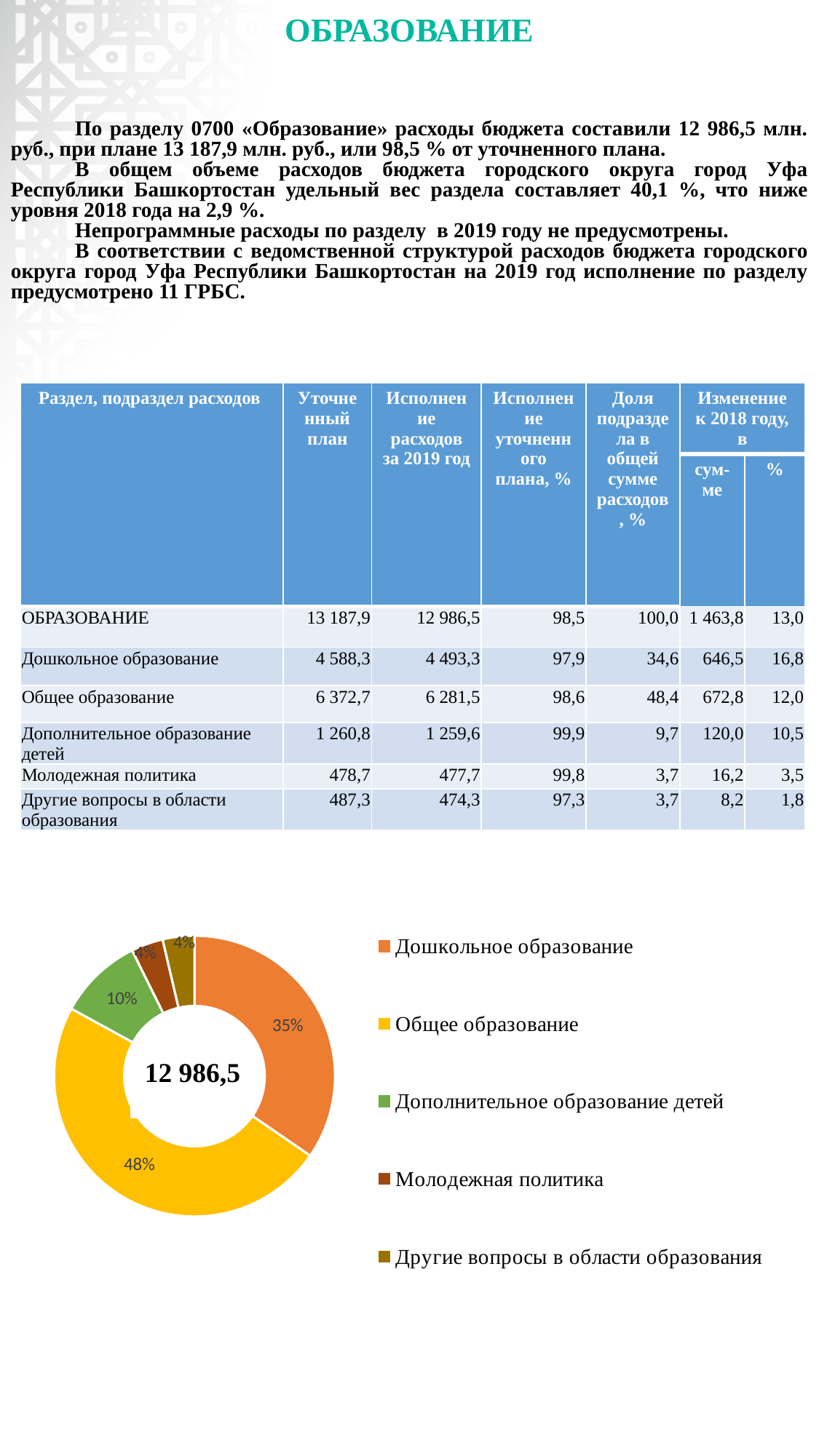
Which colour represents Общее образование in the doughnut chart? Yellow How many categories does the legend of the doughnut chart list? 5 What share of the doughnut chart does Общее образование have? 48% What value is printed in the centre of the doughnut chart? 12 986,5 Which category has the largest slice in the doughnut chart? Общее образование What share of the doughnut chart does Молодежная политика have? 4% What kind of chart is shown at the bottom of the slide? Doughnut (pie) chart What share of the doughnut chart does Дошкольное образование have? 35% Which legend entry in the doughnut chart is shown in orange? Дошкольное образование In the doughnut chart, which slice is larger: Дошкольное образование or Дополнительное образование детей? Дошкольное образование What is the difference in percentage points between the Общее образование slice and the Дошкольное образование slice in the doughnut chart? 13%